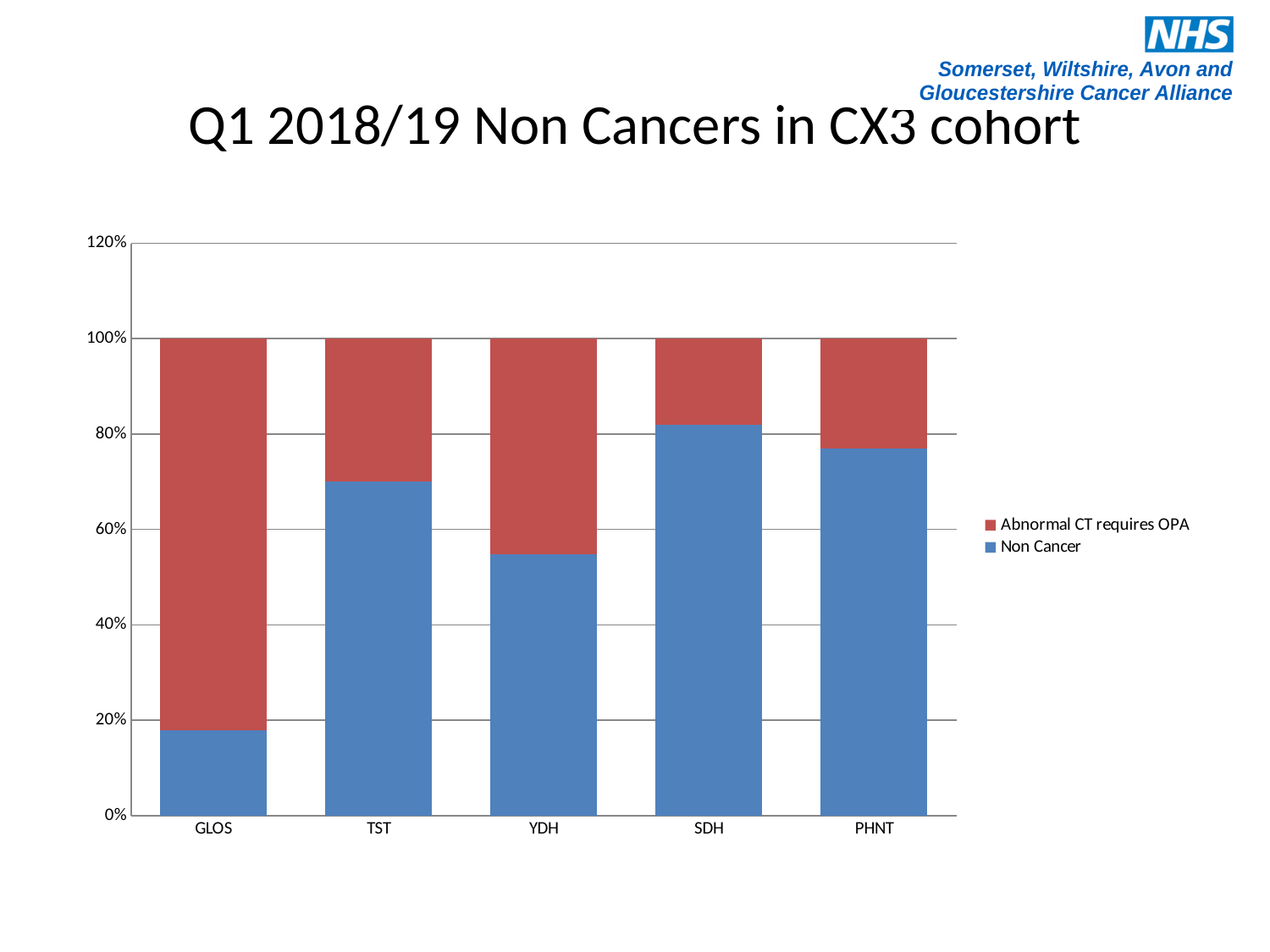
What is the total height of the stacked bar for PHNT? 100% What kind of chart is shown on the slide? Bar chart Which colour represents the Non Cancer series in the legend? Blue Which has the larger Non Cancer share, TST or YDH? TST Is the Non Cancer value for SDH greater or less than 80%? greater How many series does the legend list? 2 Is the Non Cancer value for YDH greater or less than 60%? less Is the Non Cancer value for GLOS greater or less than 20%? less How many categories (trusts) are shown on the x axis? 5 Which category has the highest Non Cancer share? SDH Which category has the lowest Non Cancer share? GLOS Which category has the largest Abnormal CT requires OPA share? GLOS